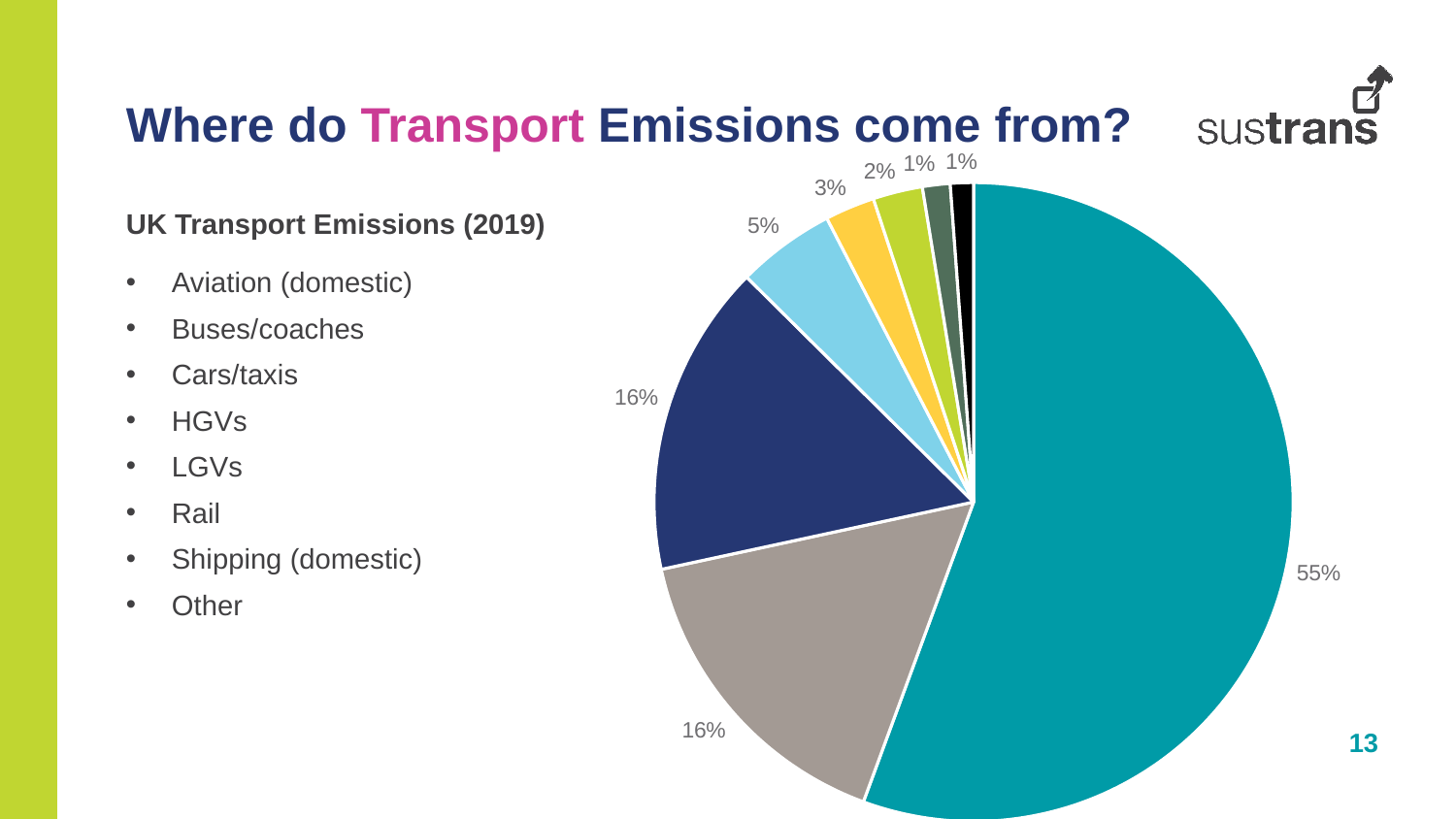
How many slices does the pie chart have? 8 What is the difference between the 16% slice and the 5% slice? 11 percentage points How many categories are listed in the bullet list next to the pie chart? 8 What is the heading above the bullet list describing the chart's data? UK Transport Emissions (2019) What is the value of the largest slice in the pie chart? 55% What is the combined share of the two 16% slices? 32% What is the value of the smallest slice in the pie chart? 1% How many slices in the pie chart are labelled 1%? 2 Is the largest slice of the pie chart greater or less than 50%? greater What percentage is shown on the teal slice of the pie chart? 55% What is the difference between the largest slice (55%) and one of the 16% slices? 39 percentage points What kind of chart is shown on the slide? pie chart